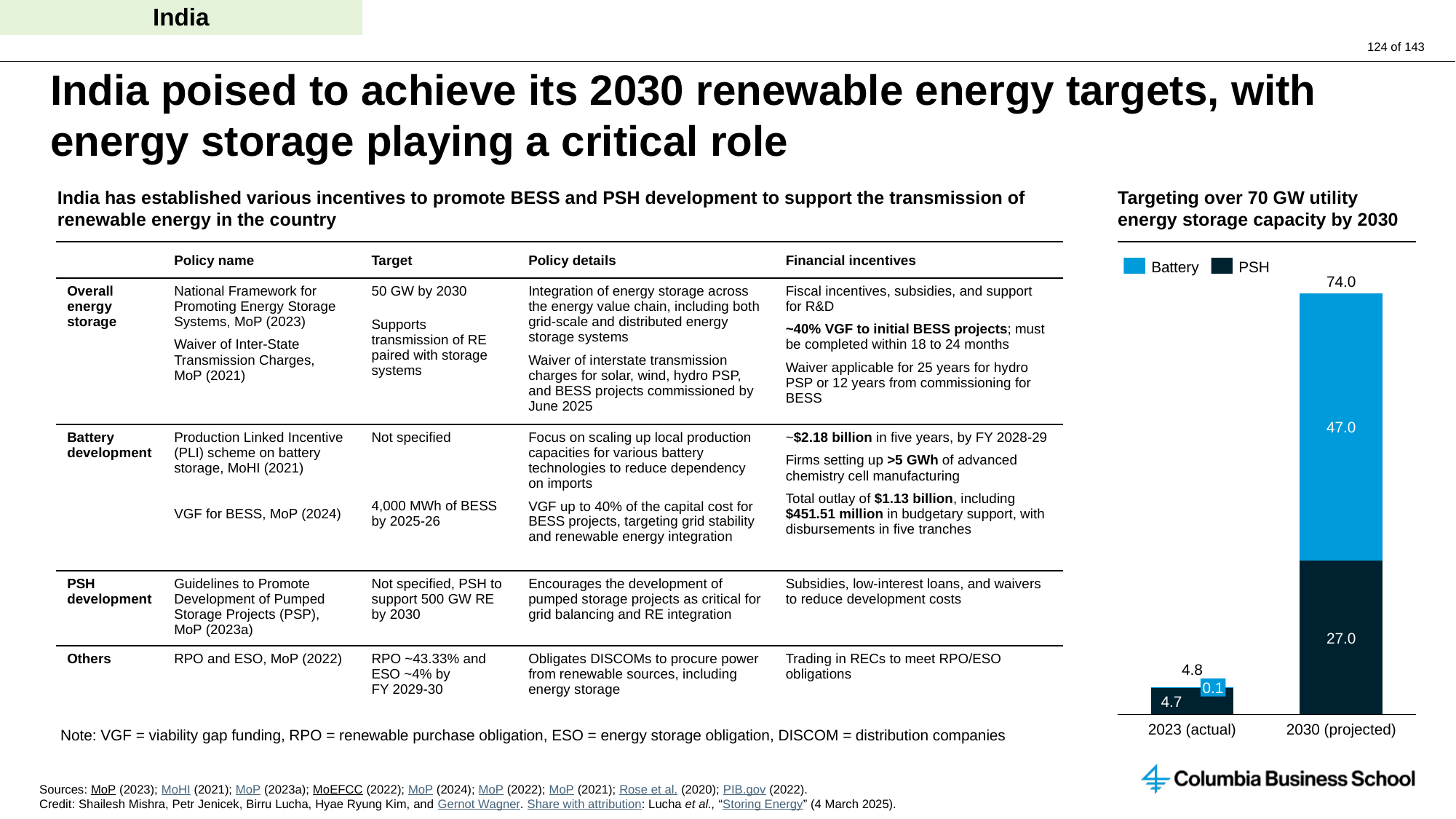
What is the PSH value for 2030 (projected)? 27.0 What kind of chart is shown on the slide? Stacked bar chart What is the PSH value for 2023 (actual)? 4.7 How many series does the chart legend list? 2 What is the total utility energy storage capacity shown for 2023 (actual)? 4.8 How many categories are shown on the x axis of the chart? 2 What is the total utility energy storage capacity shown for 2030 (projected)? 74.0 What is the Battery value for 2023 (actual)? 0.1 In 2030 (projected), which is larger, Battery or PSH? Battery What is the Battery value for 2030 (projected)? 47.0 What is the difference between the Battery and PSH values for 2030 (projected)? 20.0 Which series is shown in the darker colour in the chart legend? PSH